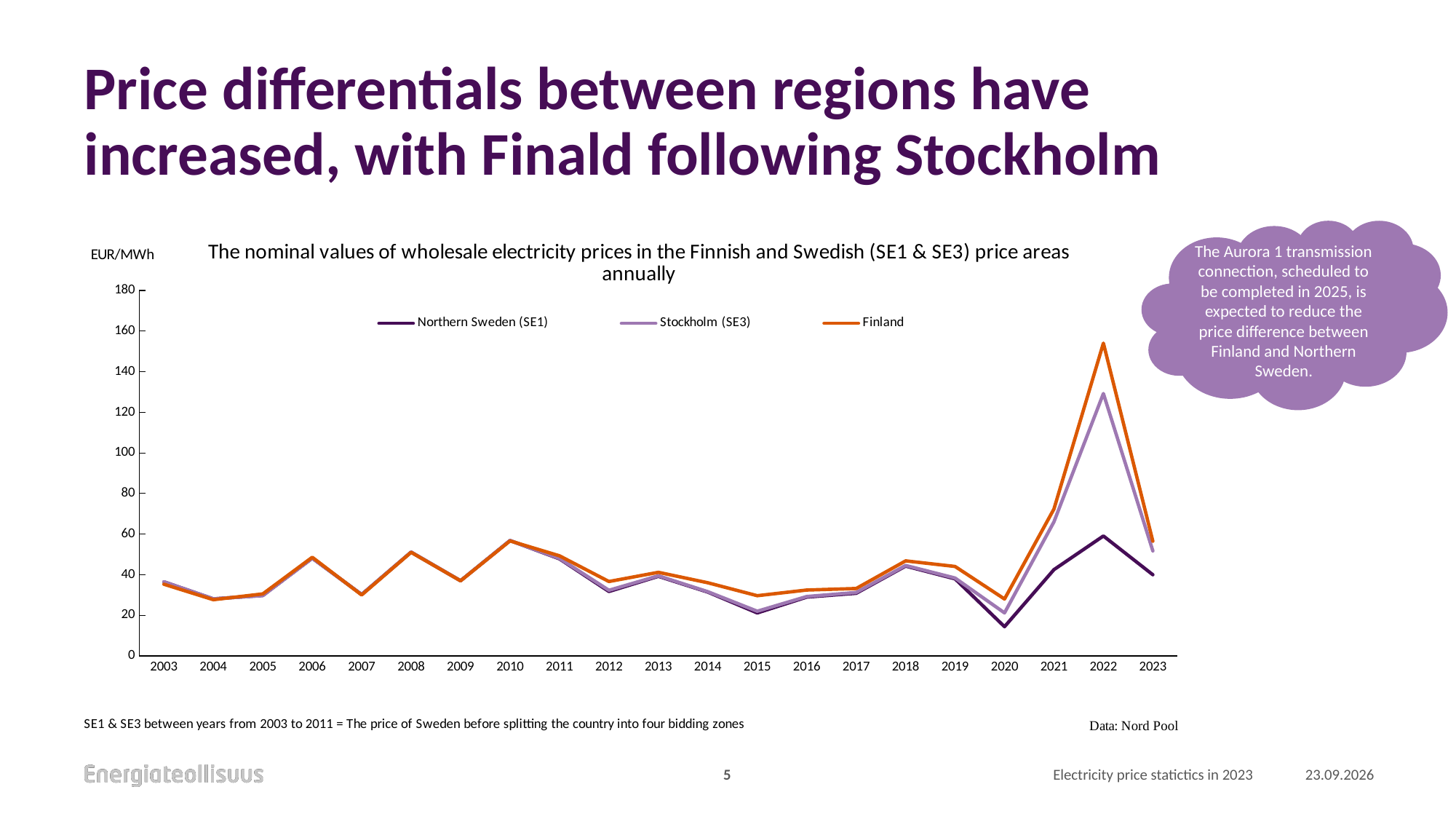
What kind of chart is shown on the slide? line chart Is the value for Finland in 2022 greater or less than 140? greater Which series has the highest value in 2022? Finland Is the value for Stockholm (SE3) in 2015 greater or less than 40? less What unit is shown above the y axis of the chart? EUR/MWh In 2022, which is larger: the value for Finland or the value for Northern Sweden (SE1)? Finland In which year is the Northern Sweden (SE1) line at its lowest? 2020 How many years are plotted along the x axis? 21 Is the value for Northern Sweden (SE1) in 2020 greater or less than 20? less How many series does the legend list? 3 Does the Finland line rise or fall from 2020 to 2022? rise In which year does the Finland line reach its highest value? 2022